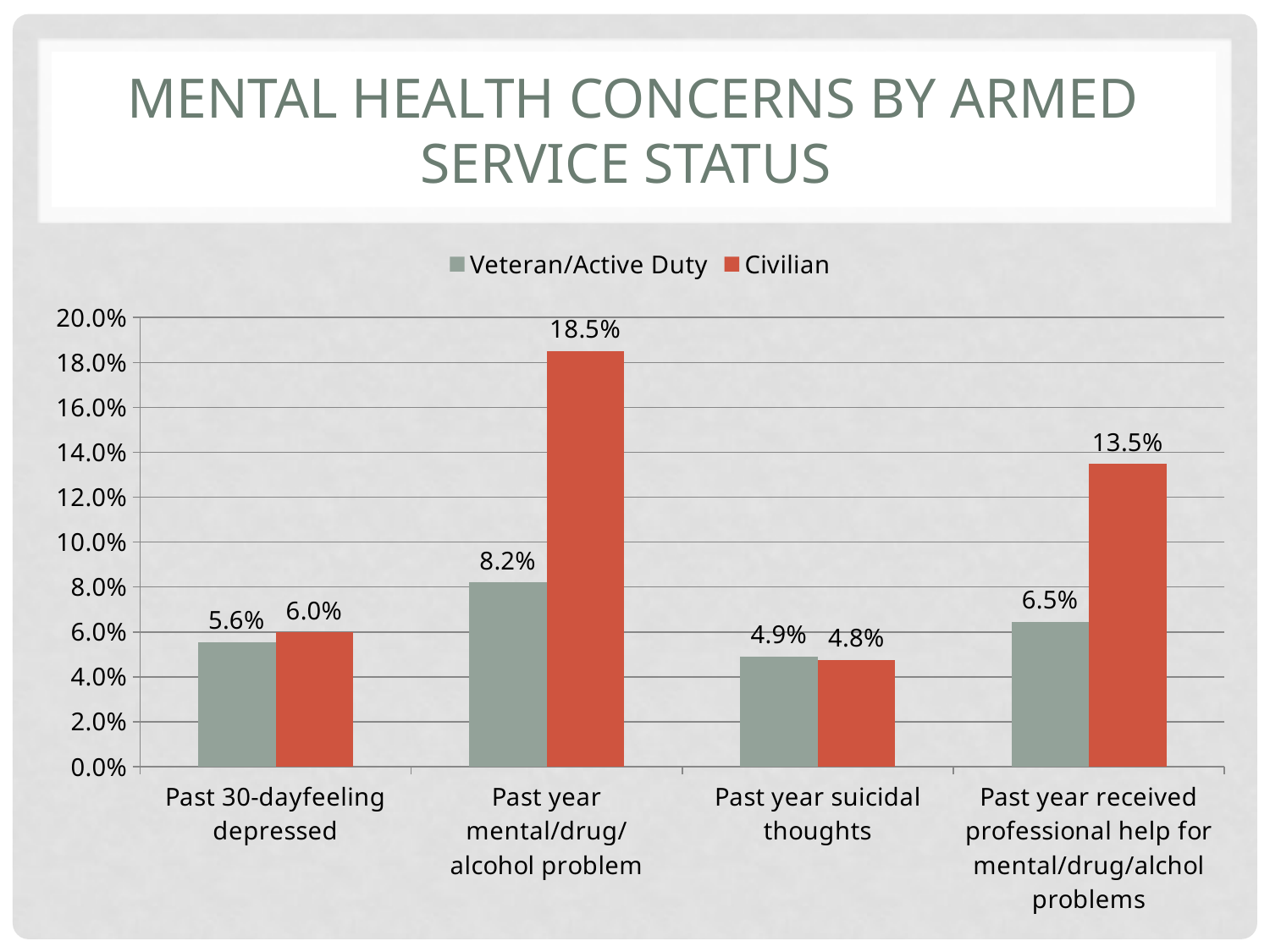
What is the difference between the Civilian and Veteran/Active Duty values for Past year mental/drug/alcohol problem? 10.3% Is the Civilian value for Past year mental/drug/alcohol problem greater or less than 16.0%? greater Which category has the highest Civilian value? Past year mental/drug/alcohol problem How many categories are shown on the x axis? 4 Which category has the lowest Veteran/Active Duty value? Past year suicidal thoughts What is the Civilian value for Past year received professional help for mental/drug/alchol problems? 13.5% What is the Civilian value for Past 30-day feeling depressed? 6.0% What is the Veteran/Active Duty value for Past year mental/drug/alcohol problem? 8.2% What kind of chart is shown on the slide? bar chart What is the title of the slide? Mental Health Concerns by Armed Service Status For Past year received professional help for mental/drug/alchol problems, which series has the larger value, Veteran/Active Duty or Civilian? Civilian How many series does the legend list? 2